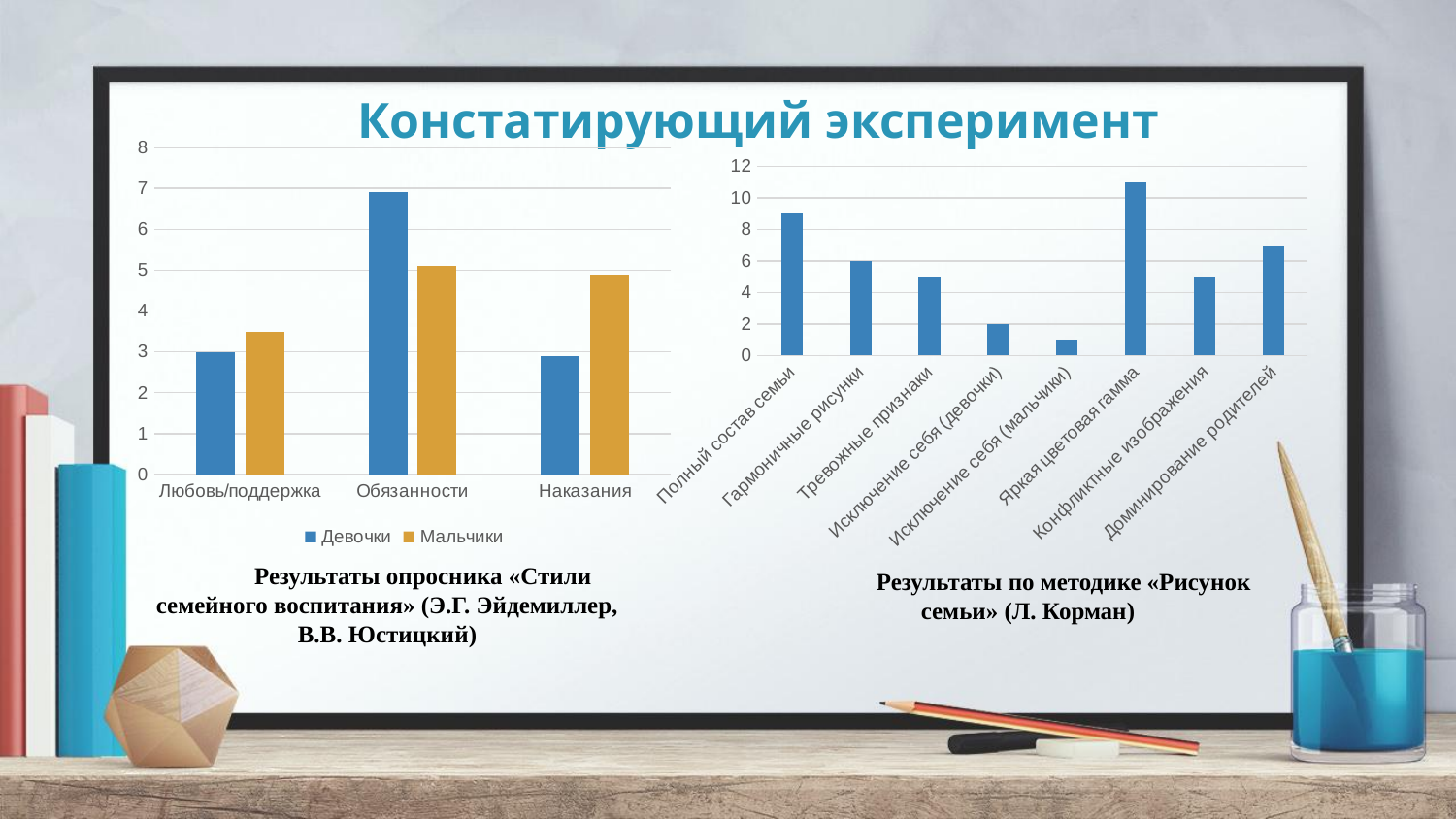
In the right chart, what is the value for Гармоничные рисунки? 6 In the left chart, which category has the lowest value for Мальчики? Любовь/поддержка In the left chart, is the value for Девочки in Обязанности greater or less than 6? greater How many series does the legend of the left chart list? 2 What kind of chart is the left chart (Результаты опросника «Стили семейного воспитания»)? bar chart How many categories are shown on the x axis of the left chart? 3 In the right chart (Результаты по методике «Рисунок семьи»), which category has the highest value? Яркая цветовая гамма In the left chart, which category has the highest value for Девочки? Обязанности In the right chart, which category has the lowest value? Исключение себя (мальчики) In the left chart, for Обязанности, which series has the larger value, Девочки or Мальчики? Девочки In the left chart, for Наказания, which series has the larger value, Девочки or Мальчики? Мальчики How many categories are shown in the right chart? 8